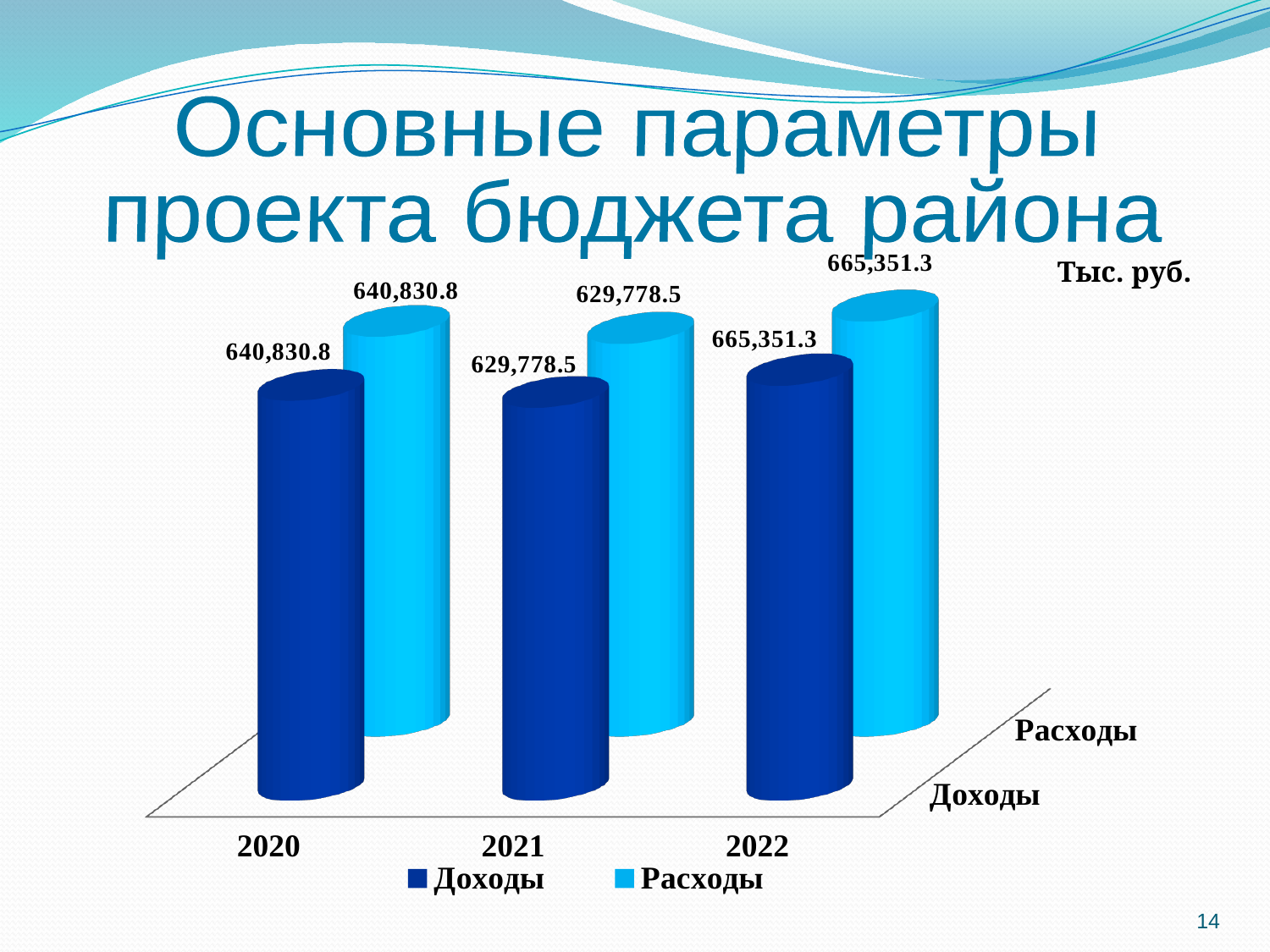
Which is larger: Доходы in 2022 or Доходы in 2021? Доходы in 2022 What kind of chart is shown on the slide? Bar chart What is the difference between Расходы in 2020 and Расходы in 2021? 11,052.3 In which year is Расходы the lowest? 2021 How many series does the legend list? 2 What is the value of Доходы for 2020? 640,830.8 What is the value of Расходы for 2022? 665,351.3 What is the value of Расходы for 2021? 629,778.5 What is the value of Доходы for 2022? 665,351.3 In which year is Доходы the highest? 2022 What is the difference between Доходы in 2022 and Доходы in 2020? 24,520.5 How many years are shown on the x axis? 3